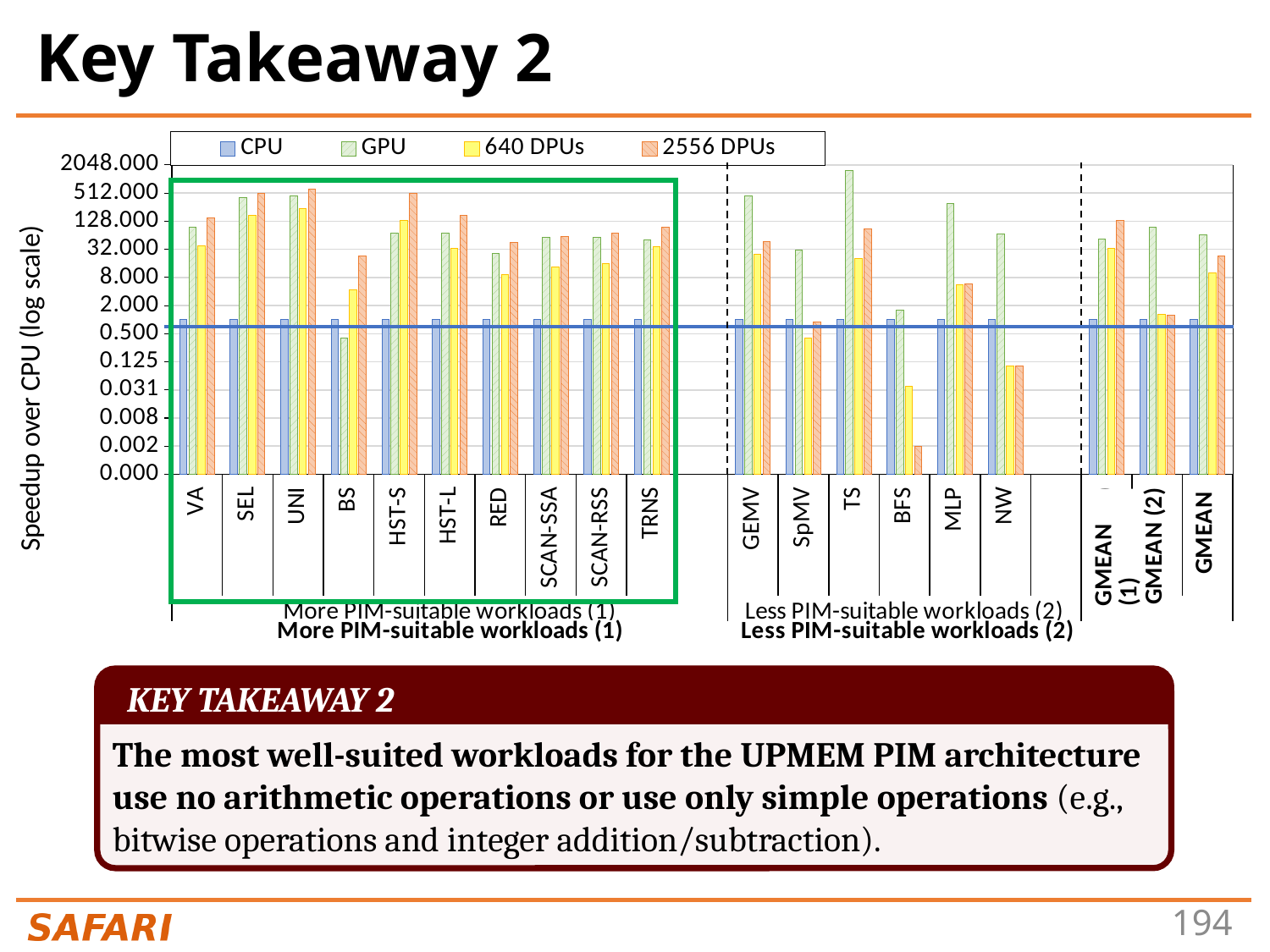
What kind of chart is shown on the slide? bar chart How many workload categories are plotted along the x axis, including the GMEAN categories? 19 How many series does the legend list? 4 Which workload has the highest GPU speedup? TS What is the label of the y axis? Speedup over CPU (log scale) Is the 2556 DPUs value for BFS greater or less than 0.125? less Is the GPU value for TS greater or less than 512? greater For VA, which is larger: the 640 DPUs speedup or the 2556 DPUs speedup? 2556 DPUs For GEMV, which is larger: the GPU speedup or the 2556 DPUs speedup? GPU Is the 640 DPUs value for VA greater or less than 8? greater Which series are listed in the legend? CPU, GPU, 640 DPUs, 2556 DPUs Which workload has the lowest 2556 DPUs speedup? BFS